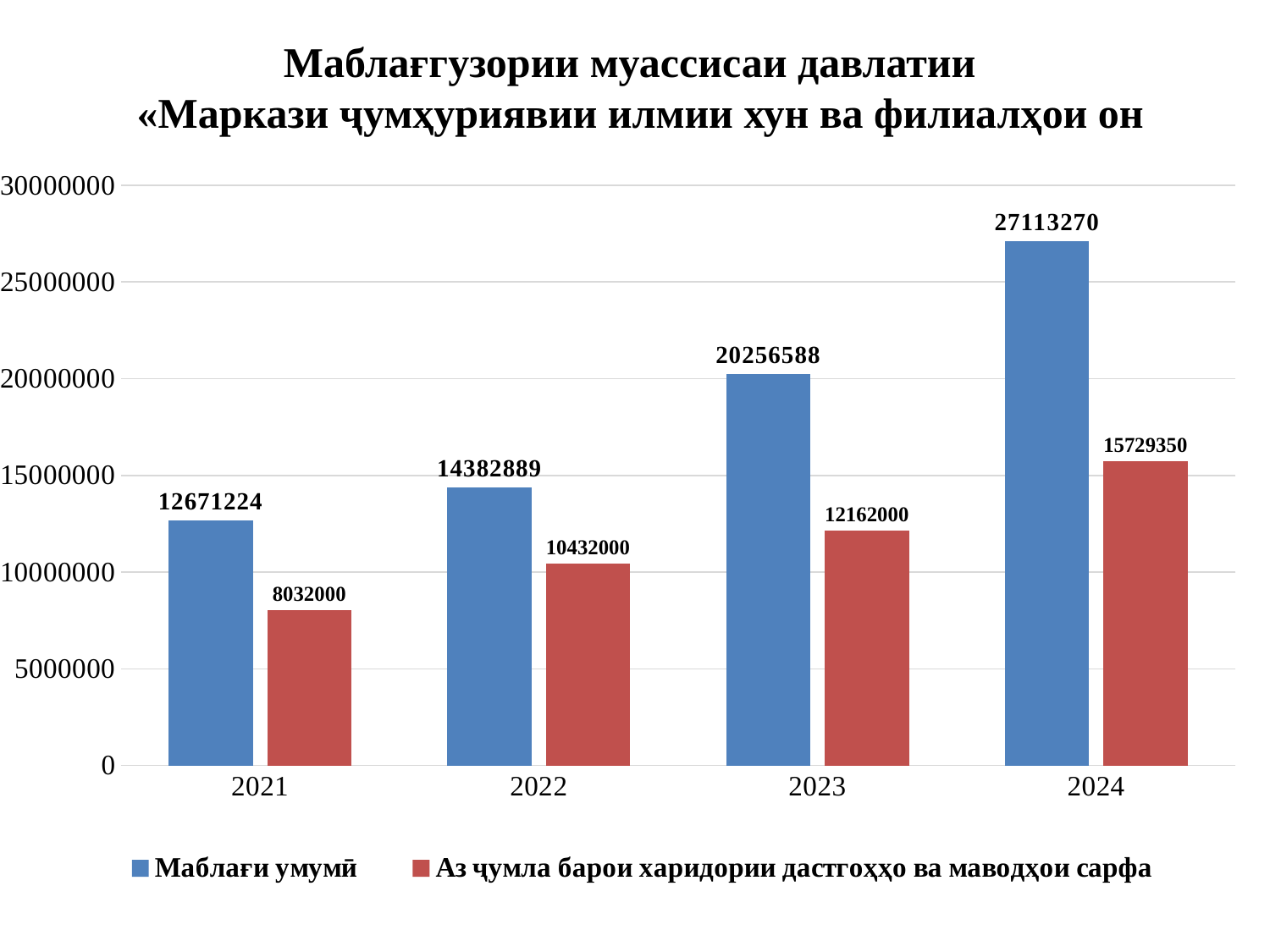
What is the difference between Маблағи умумӣ and Аз ҷумла барои харидории дастгоҳҳо ва маводҳои сарфа in 2024? 11383920 Which is larger: Маблағи умумӣ in 2021 or Аз ҷумла барои харидории дастгоҳҳо ва маводҳои сарфа in 2024? Аз ҷумла барои харидории дастгоҳҳо ва маводҳои сарфа in 2024 What is the value of Маблағи умумӣ for 2022? 14382889 In which year is Маблағи умумӣ highest? 2024 How many years are shown on the x axis? 4 By how much did Маблағи умумӣ increase from 2022 to 2023? 5873699 In which year is Аз ҷумла барои харидории дастгоҳҳо ва маводҳои сарфа lowest? 2021 How many series does the legend list? 2 What is the value of Маблағи умумӣ for 2024? 27113270 Does Маблағи умумӣ rise or fall from 2021 to 2024? rise What is the value of Аз ҷумла барои харидории дастгоҳҳо ва маводҳои сарфа for 2021? 8032000 What is the value of Аз ҷумла барои харидории дастгоҳҳо ва маводҳои сарфа for 2023? 12162000